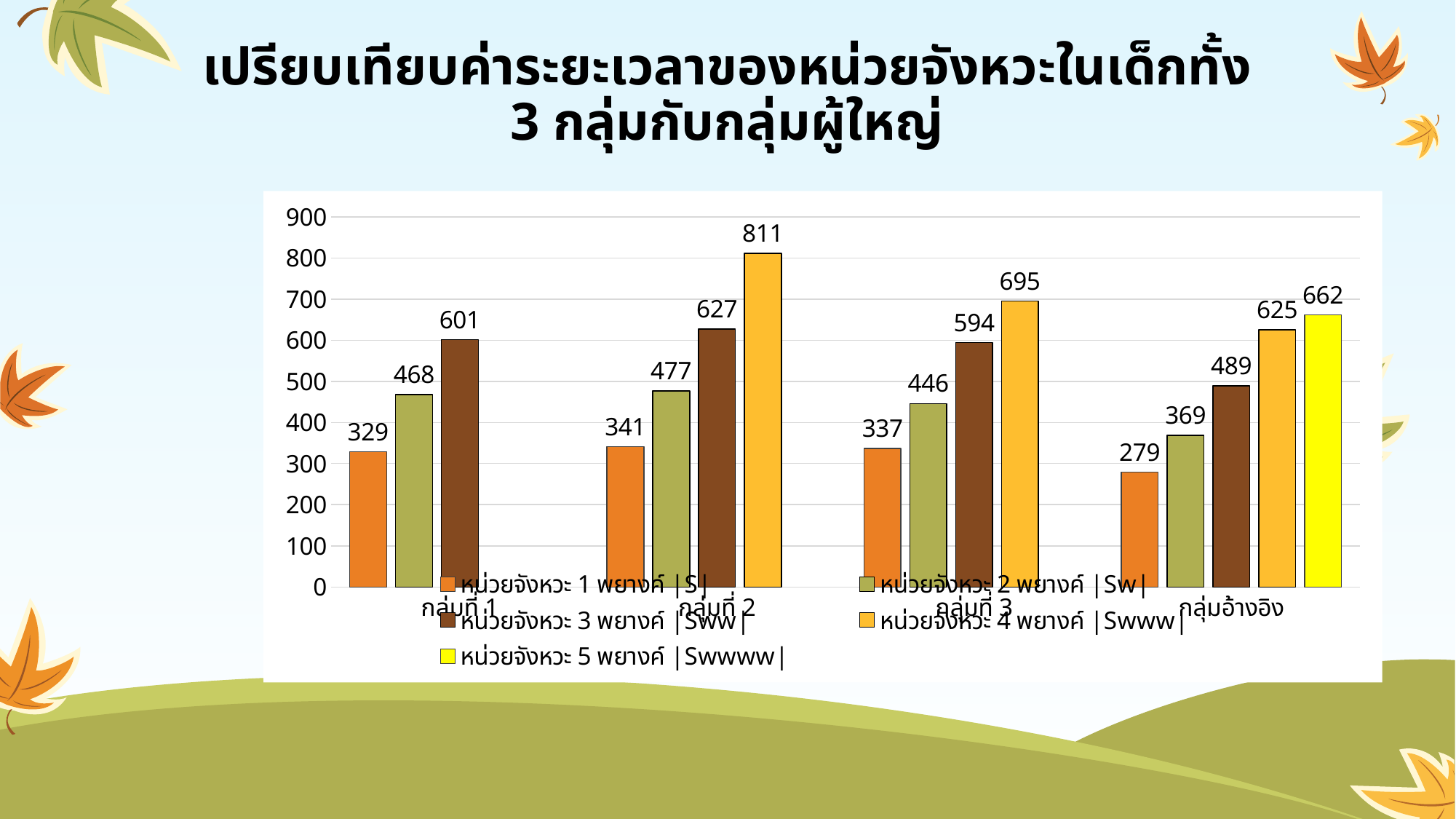
Which is larger: the หน่วยจังหวะ 2 พยางค์ |Sw| value for กลุ่มที่ 1 or for กลุ่มที่ 3? กลุ่มที่ 1 (468) What is the value for หน่วยจังหวะ 1 พยางค์ |S| in กลุ่มอ้างอิง? 279 What type of chart is shown on the slide? bar chart What is the value for หน่วยจังหวะ 3 พยางค์ |Sww| in กลุ่มที่ 3? 594 How many series does the legend list? 5 What is the difference between the หน่วยจังหวะ 4 พยางค์ |Swww| values for กลุ่มที่ 2 and กลุ่มที่ 3? 116 How many category groups are shown on the x axis? 4 What is the value for หน่วยจังหวะ 4 พยางค์ |Swww| in กลุ่มที่ 2? 811 What is the value for หน่วยจังหวะ 5 พยางค์ |Swwww| in กลุ่มอ้างอิง? 662 Which bar has the lowest value in the whole chart? หน่วยจังหวะ 1 พยางค์ |S| in กลุ่มอ้างอิง (279) Which category group is the only one with a หน่วยจังหวะ 5 พยางค์ |Swwww| bar? กลุ่มอ้างอิง Which bar has the highest value in the whole chart? หน่วยจังหวะ 4 พยางค์ |Swww| in กลุ่มที่ 2 (811)